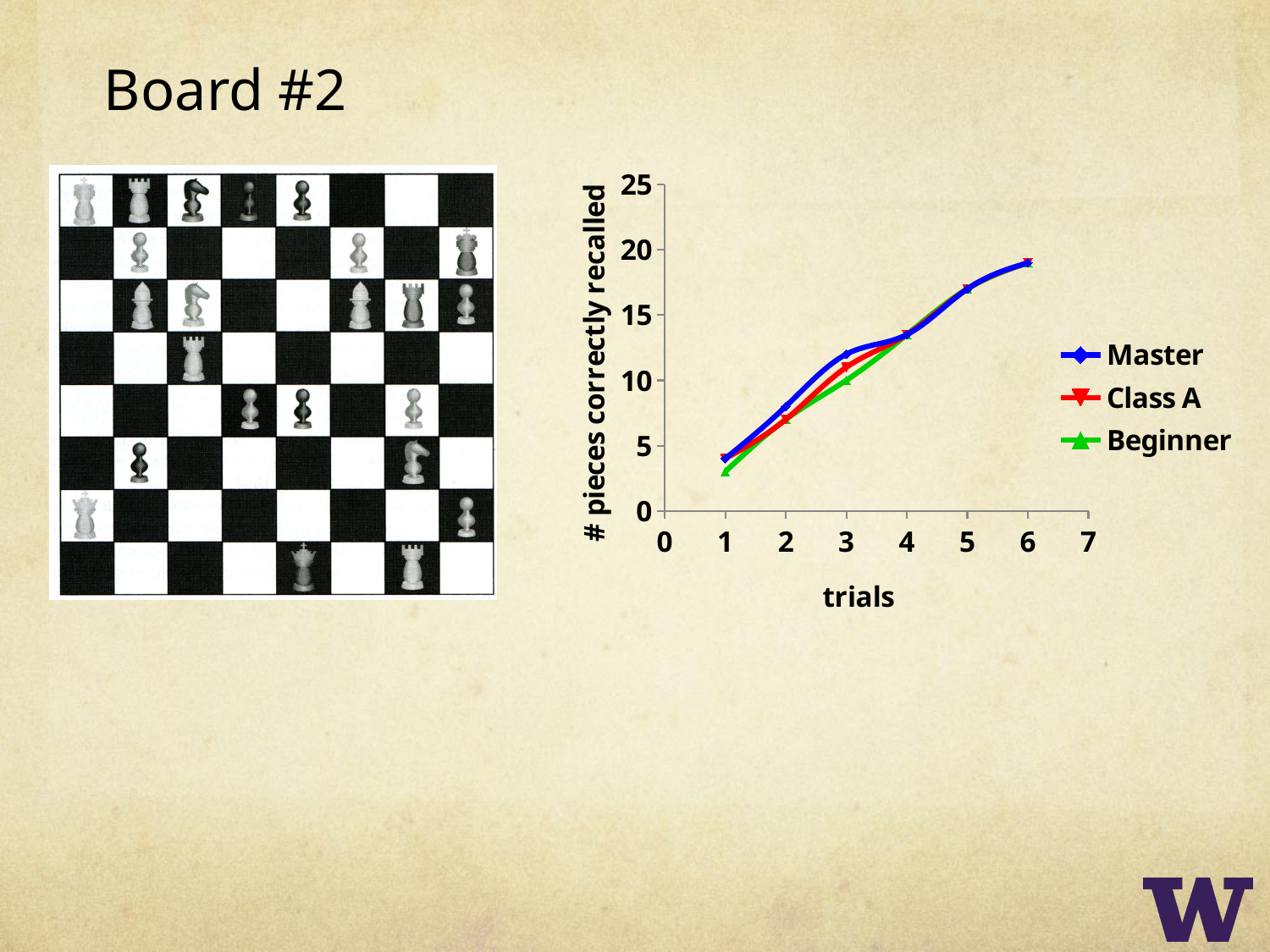
What colour is the Master series in the chart? blue Do the values for Master rise or fall as the number of trials increases? rise Is the value for Class A at trial 5 greater or less than 15? greater Is the value for Beginner at trial 2 greater or less than 5? greater How many series does the chart's legend list? 3 What kind of chart is shown on the slide? line chart How many trials are plotted for each series in the chart? 6 Is the value for Beginner at trial 1 greater or less than 5? less At trial 3, which series has the higher value, Master or Beginner? Master What is the label on the chart's y axis? # pieces correctly recalled